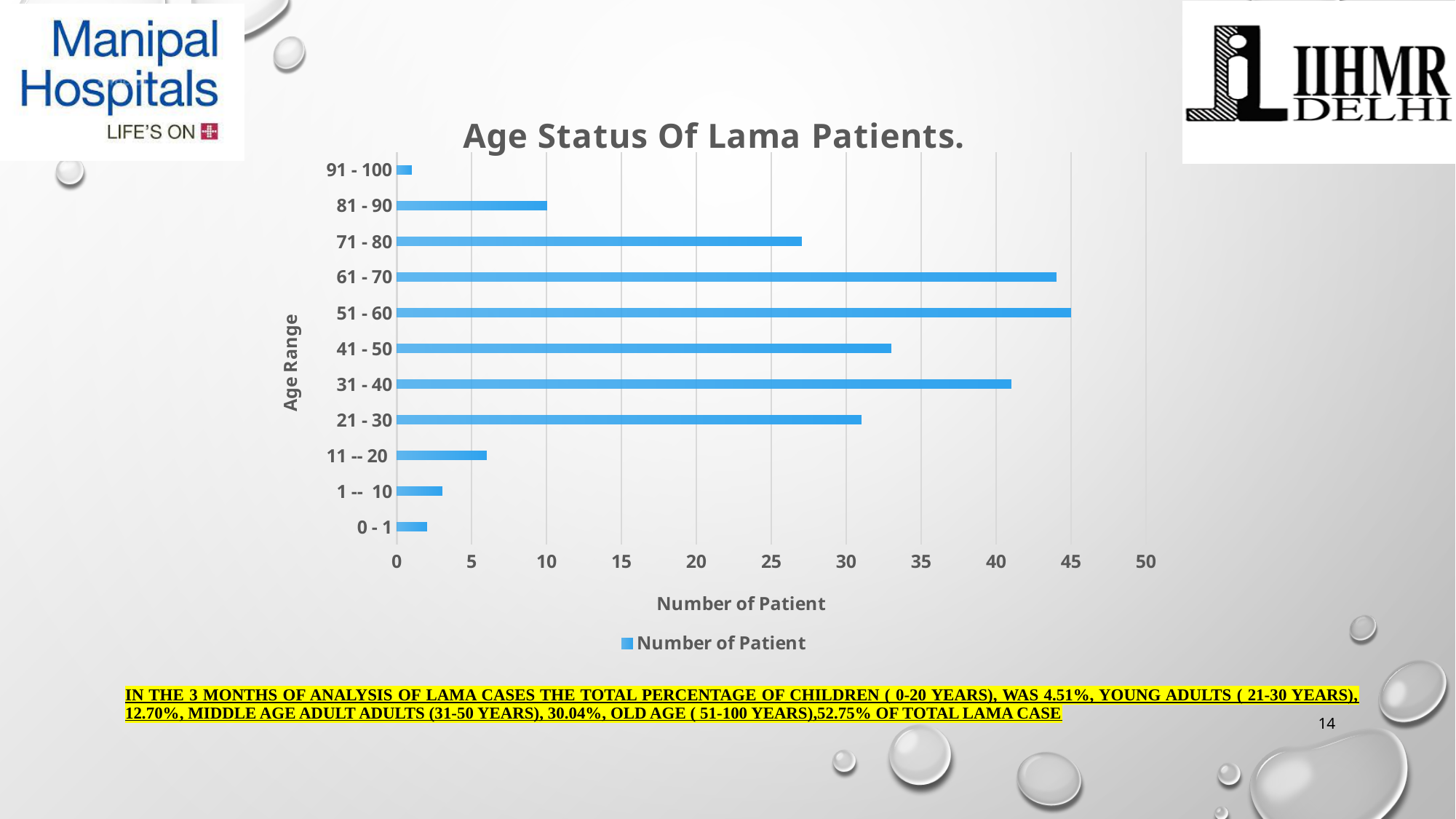
How many series does the chart legend list? 1 What is the title of the chart? Age Status Of Lama Patients. Which age range has more patients, 31 - 40 or 21 - 30? 31 - 40 Is the number of patients for the 61 - 70 age range greater or less than 40? greater What is the label of the x axis of the chart? Number of Patient How many age range categories are plotted in the chart? 11 What is the number of patients for the 51 - 60 age range? 45 What is the number of patients for the 81 - 90 age range? 10 What type of chart is shown on the slide? Bar chart Which age range has more patients, 41 - 50 or 71 - 80? 41 - 50 Is the number of patients for the 11 -- 20 age range greater or less than 5? greater Is the number of patients for the 71 - 80 age range greater or less than 30? less